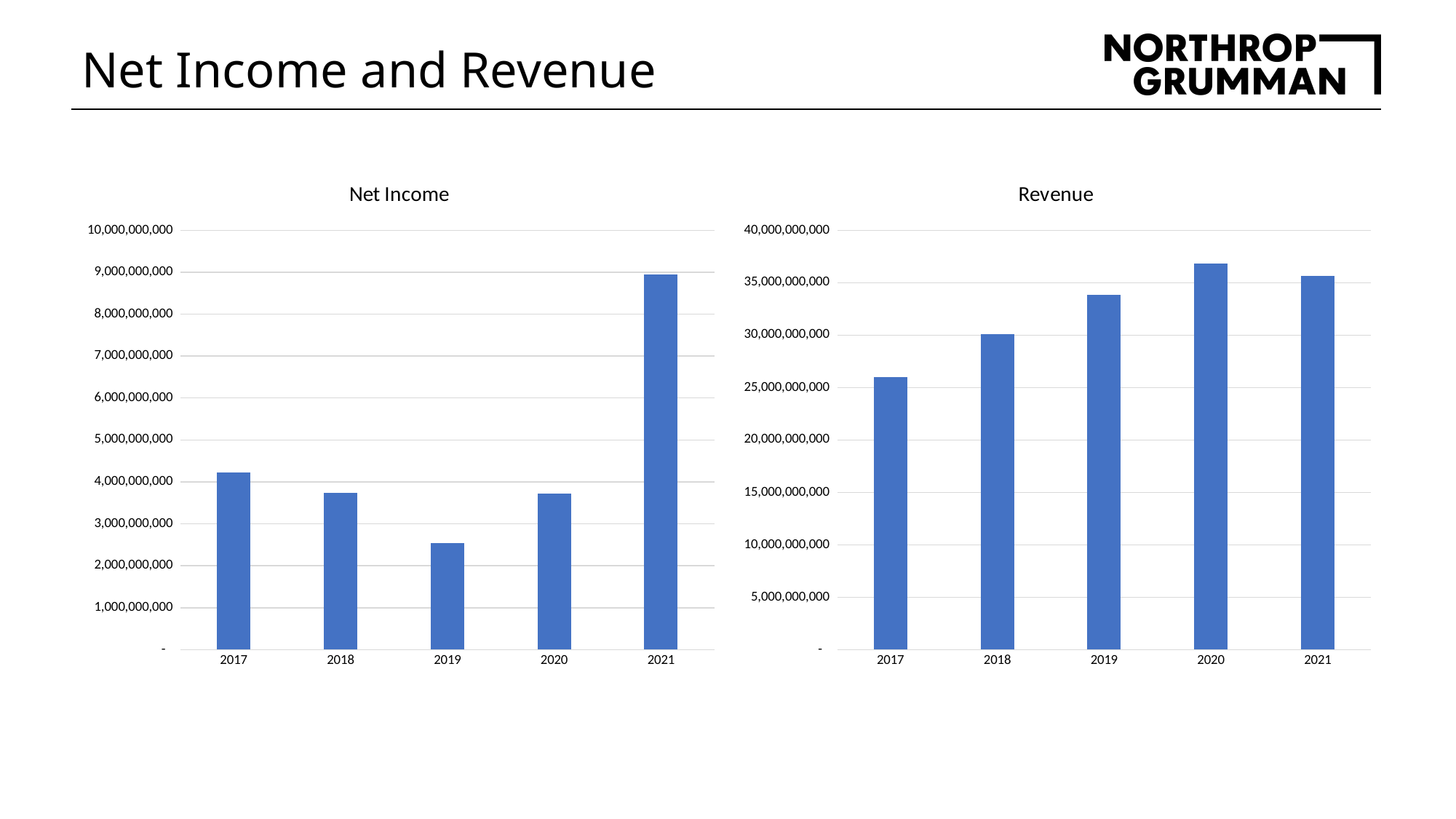
In the Net Income chart, is the value for 2021 greater or less than 8,000,000,000? greater How many years are shown in the Net Income chart? 5 In the Net Income chart, which year has the lowest net income? 2019 In the Revenue chart, is the value for 2019 greater or less than 30,000,000,000? greater In the Revenue chart, which is larger, the value for 2021 or the value for 2017? 2021 What kind of chart is the Net Income chart? bar chart In the Net Income chart, which year has the highest net income? 2021 In the Revenue chart, which year has the highest revenue? 2020 In the Net Income chart, is the value for 2019 greater or less than 3,000,000,000? less In the Revenue chart, which year has the lowest revenue? 2017 In the Net Income chart, which is larger, the value for 2017 or the value for 2019? 2017 In the Revenue chart, do the values rise or fall from 2017 to 2020? rise